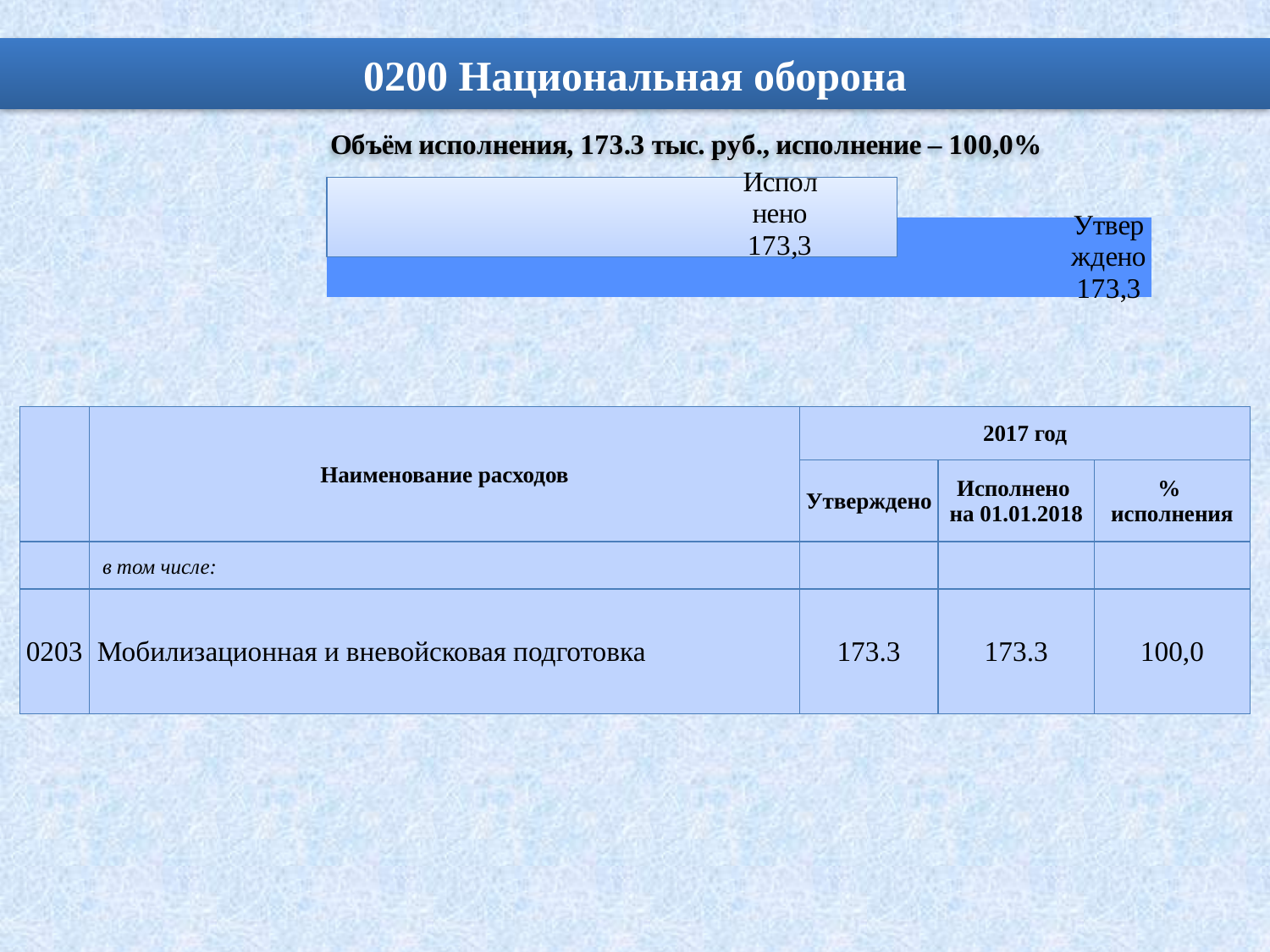
Are the values of the "Исполнено" and "Утверждено" bars equal? Yes What is the difference between the "Утверждено" and "Исполнено" bars? 0 How many bars does the chart show? 2 Which bar is positioned above the other on the chart? Исполнено What are the labels of the two bars in the chart? Исполнено and Утверждено What is the value of the bar labelled "Утверждено"? 173,3 What is the value of the bar labelled "Исполнено"? 173,3 What kind of chart is shown on the slide? bar chart